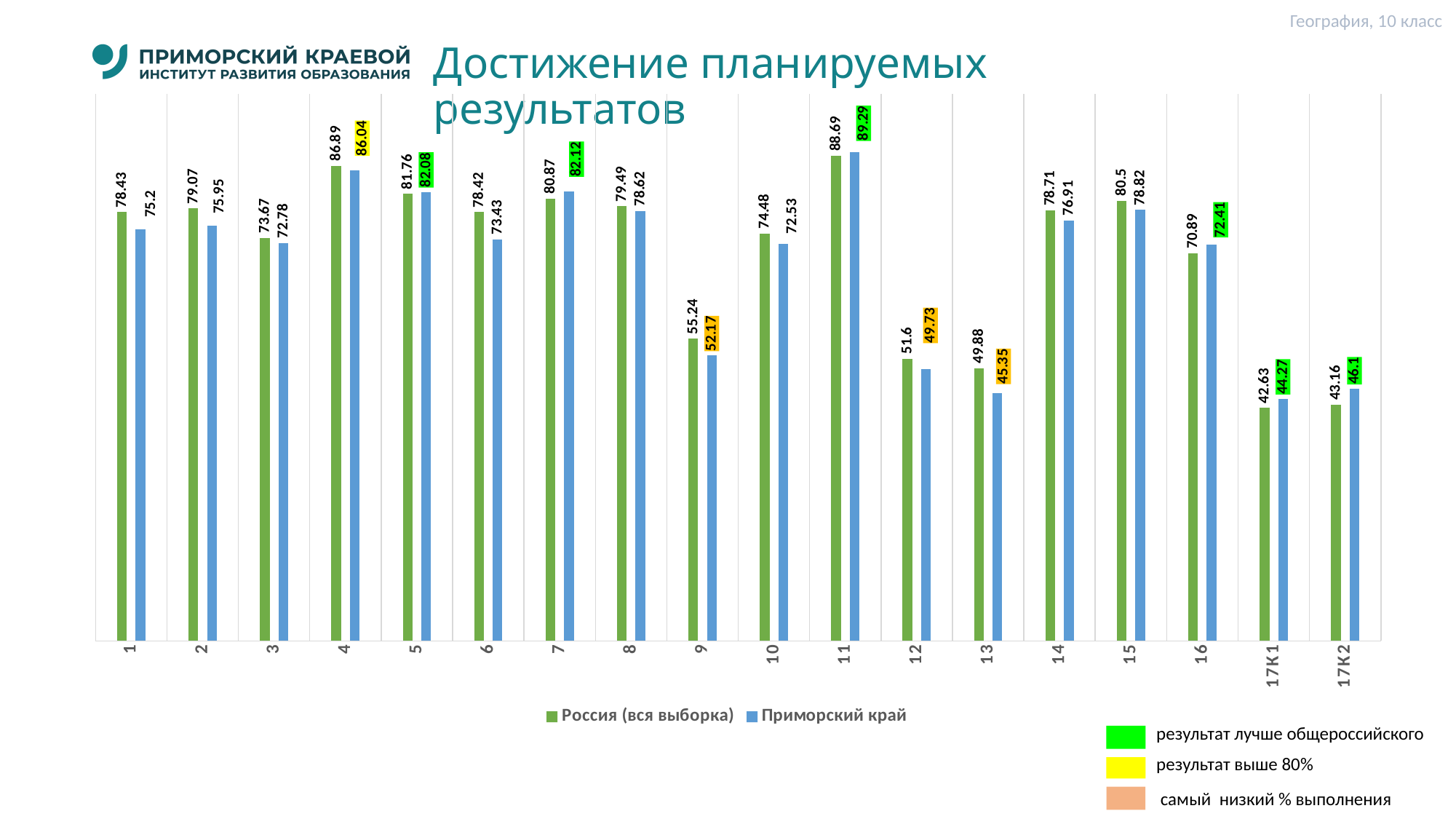
Which task has the highest value for Приморский край? 11 What is the difference between Россия (вся выборка) and Приморский край for task 6? 4.99 For task 16, which series has the larger value: Россия (вся выборка) or Приморский край? Приморский край What is the value for Приморский край for task 17К2? 46.1 What is the difference between Приморский край and Россия (вся выборка) for task 11? 0.6 How many series does the chart legend list? 2 What kind of chart is shown on the slide? Bar chart Which task has the lowest value for Россия (вся выборка)? 17К1 What is the value for Россия (вся выборка) for task 9? 55.24 How many categories are shown on the x axis of the chart? 18 What is the value for Приморский край for task 4? 86.04 For task 13, which series has the larger value: Россия (вся выборка) or Приморский край? Россия (вся выборка)